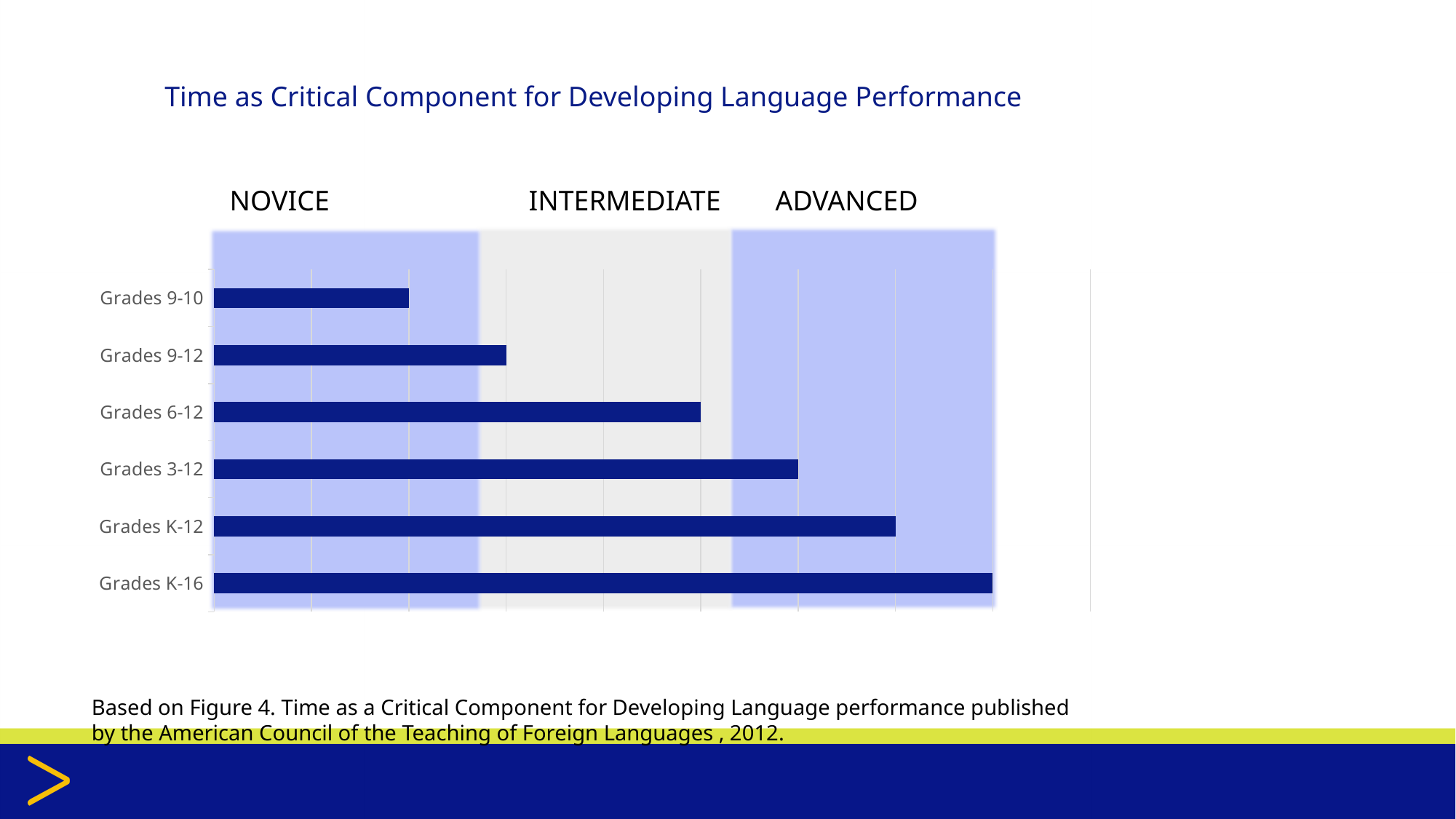
How many grade-range categories are plotted in the chart? 6 Which proficiency band does the Grades 6-12 bar end in? INTERMEDIATE What type of chart is shown on the slide? bar chart What are the three proficiency bands labelled above the chart? NOVICE, INTERMEDIATE, ADVANCED Which proficiency band does the Grades 9-10 bar end in? NOVICE Which grade range has the shortest bar in the chart? Grades 9-10 Which grade range has the longest bar in the chart? Grades K-16 Which bar is longer, Grades 6-12 or Grades 9-12? Grades 6-12 Do the bars get longer or shorter going down the list from Grades 9-10 to Grades K-16? longer Which bar is longer, Grades K-12 or Grades 3-12? Grades K-12 What is the title of the chart? Time as Critical Component for Developing Language Performance Which bar is longer, Grades 9-10 or Grades K-16? Grades K-16